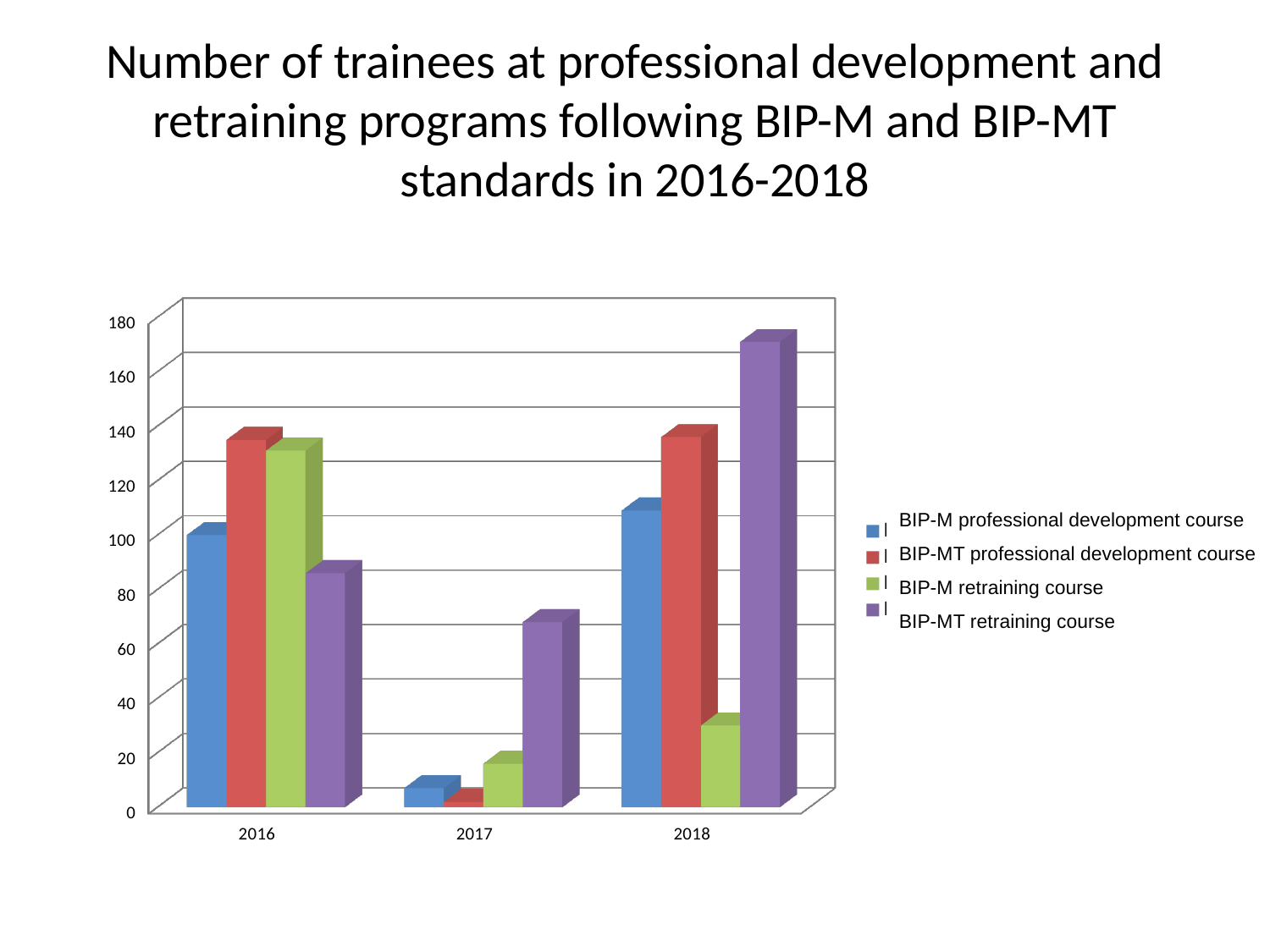
What kind of chart is shown on the slide? bar chart Which year has the highest value for the BIP-MT retraining course? 2018 Is the value for the BIP-M retraining course in 2018 greater or less than 60? less Is the value for the BIP-MT retraining course in 2017 greater or less than 100? less How many years are shown on the x axis? 3 Which year has the lowest value for the BIP-M professional development course? 2017 Is the value for the BIP-M professional development course in 2016 greater or less than 80? greater Which series has the highest value in 2018? BIP-MT retraining course In 2018, which is larger: the BIP-MT retraining course or the BIP-MT professional development course? BIP-MT retraining course How many series does the legend list? 4 Does the value for the BIP-M professional development course rise or fall from 2016 to 2017? fall Which series has the lowest value in 2017? BIP-MT professional development course